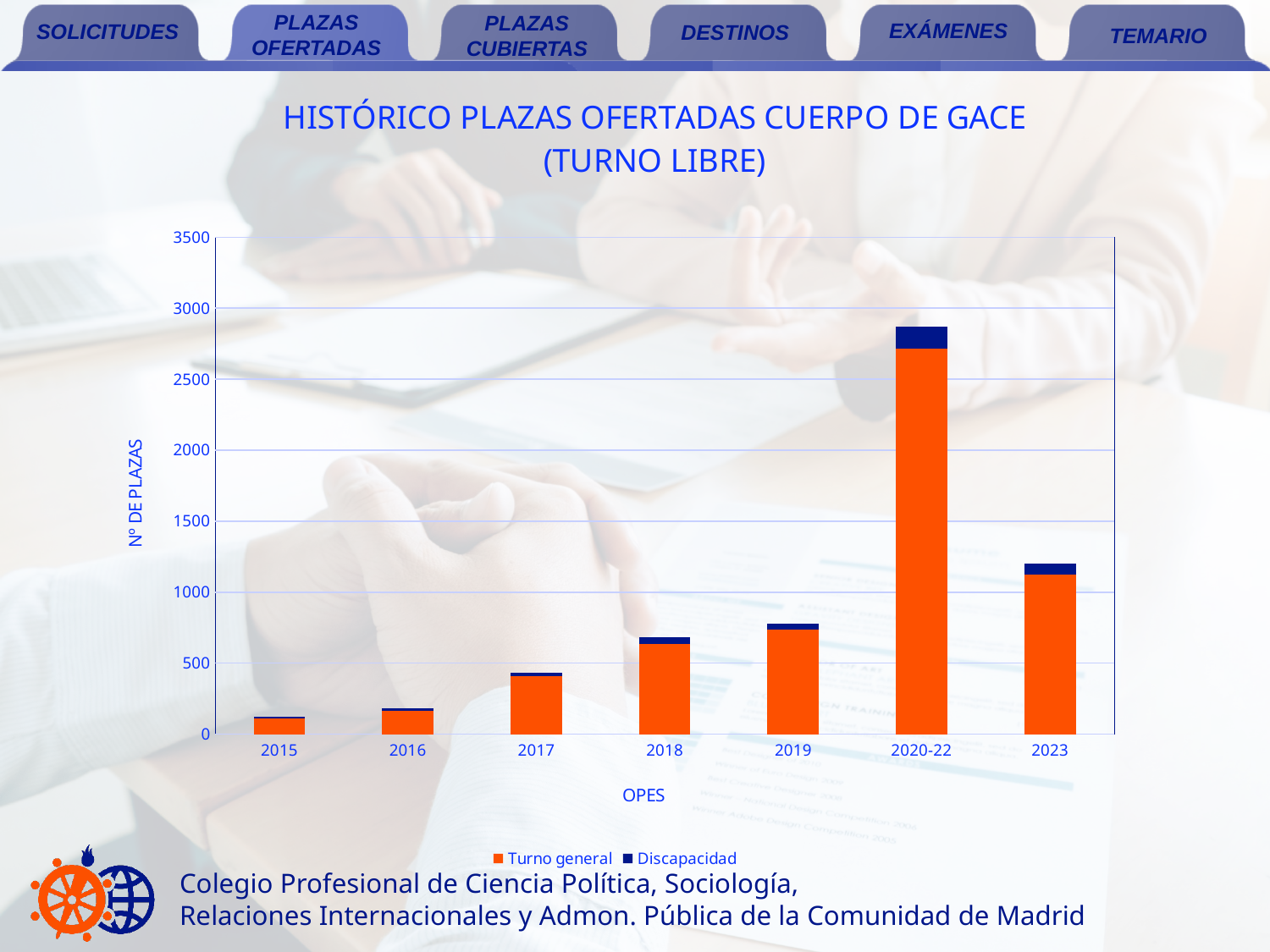
Which has a larger total bar, 2018 or 2023? 2023 What kind of chart is shown on the slide? stacked bar chart What is the label of the y axis of the chart? Nº DE PLAZAS Which category has the highest total bar in the chart? 2020-22 Is the total bar for 2019 greater or less than 1000? less Is the total bar for 2020-22 greater or less than 2500? greater How many series does the chart legend list? 2 Which category has the lowest total bar in the chart? 2015 Do the total bar values rise or fall from 2015 to 2020-22? rise How many categories (OPES) are shown on the x axis of the chart? 7 Is the total bar for 2017 greater or less than 500? less